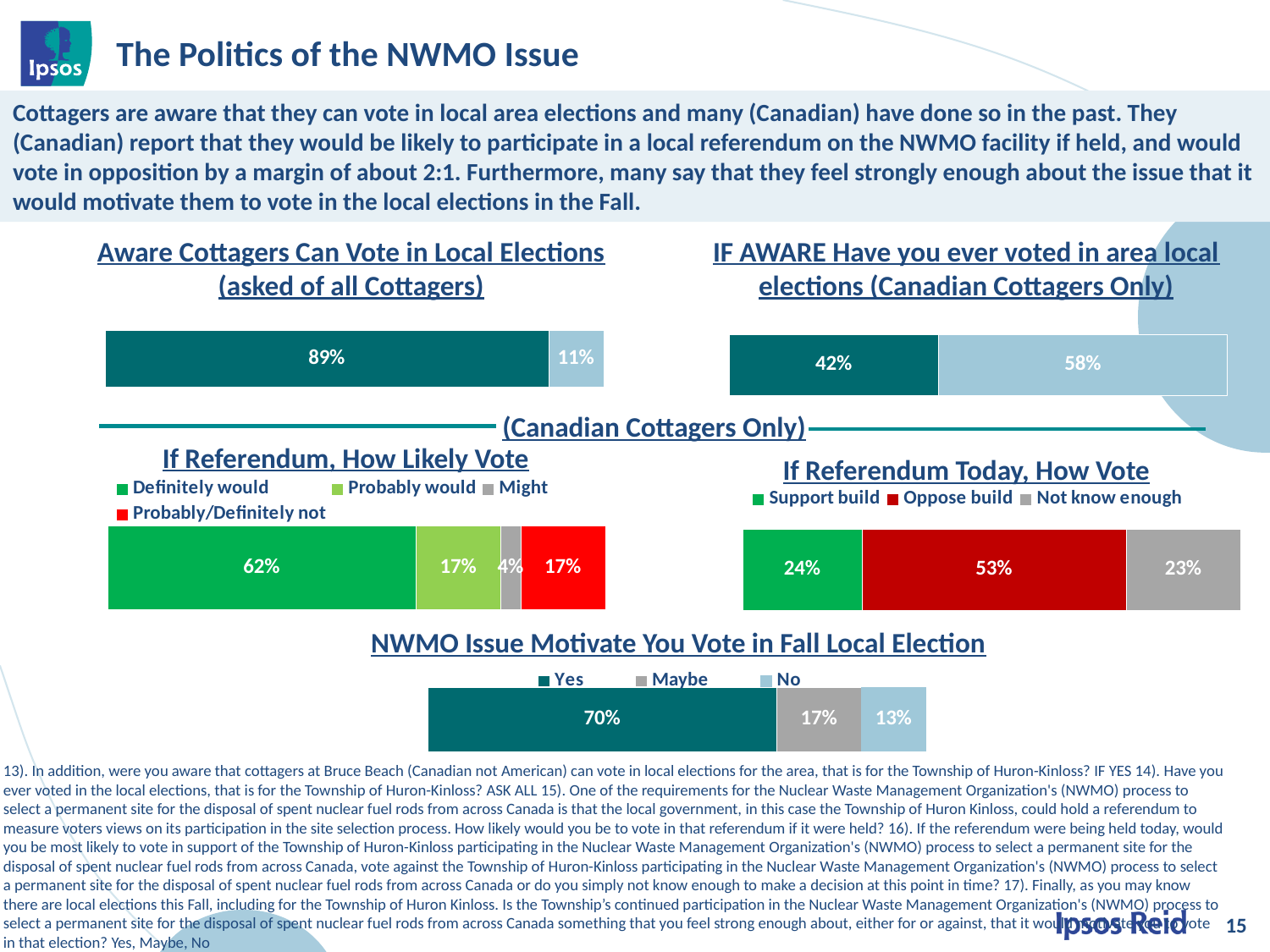
How many series does the legend of the 'If Referendum, How Likely Vote' chart list? 4 In the 'NWMO Issue Motivate You Vote in Fall Local Election' chart, what percentage answered No? 13% In the 'If Referendum Today, How Vote' chart, what is the difference between the Oppose build and Support build percentages? 29% In the 'If Referendum, How Likely Vote' chart, what percentage say they definitely would vote? 62% In the 'If Referendum Today, How Vote' chart, what percentage would oppose the build? 53% In the 'If Referendum, How Likely Vote' chart, which response has the lowest percentage? Might In the 'NWMO Issue Motivate You Vote in Fall Local Election' chart, what percentage answered Yes? 70% In the 'If Referendum, How Likely Vote' chart, what percentage say they might vote? 4% In the 'If Referendum Today, How Vote' chart, which response has the highest percentage? Oppose build What is the largest value shown in the 'Aware Cottagers Can Vote in Local Elections' chart? 89% In the 'If Referendum Today, How Vote' chart, what percentage would support the build? 24% In the 'NWMO Issue Motivate You Vote in Fall Local Election' chart, which is larger, Maybe or No? Maybe